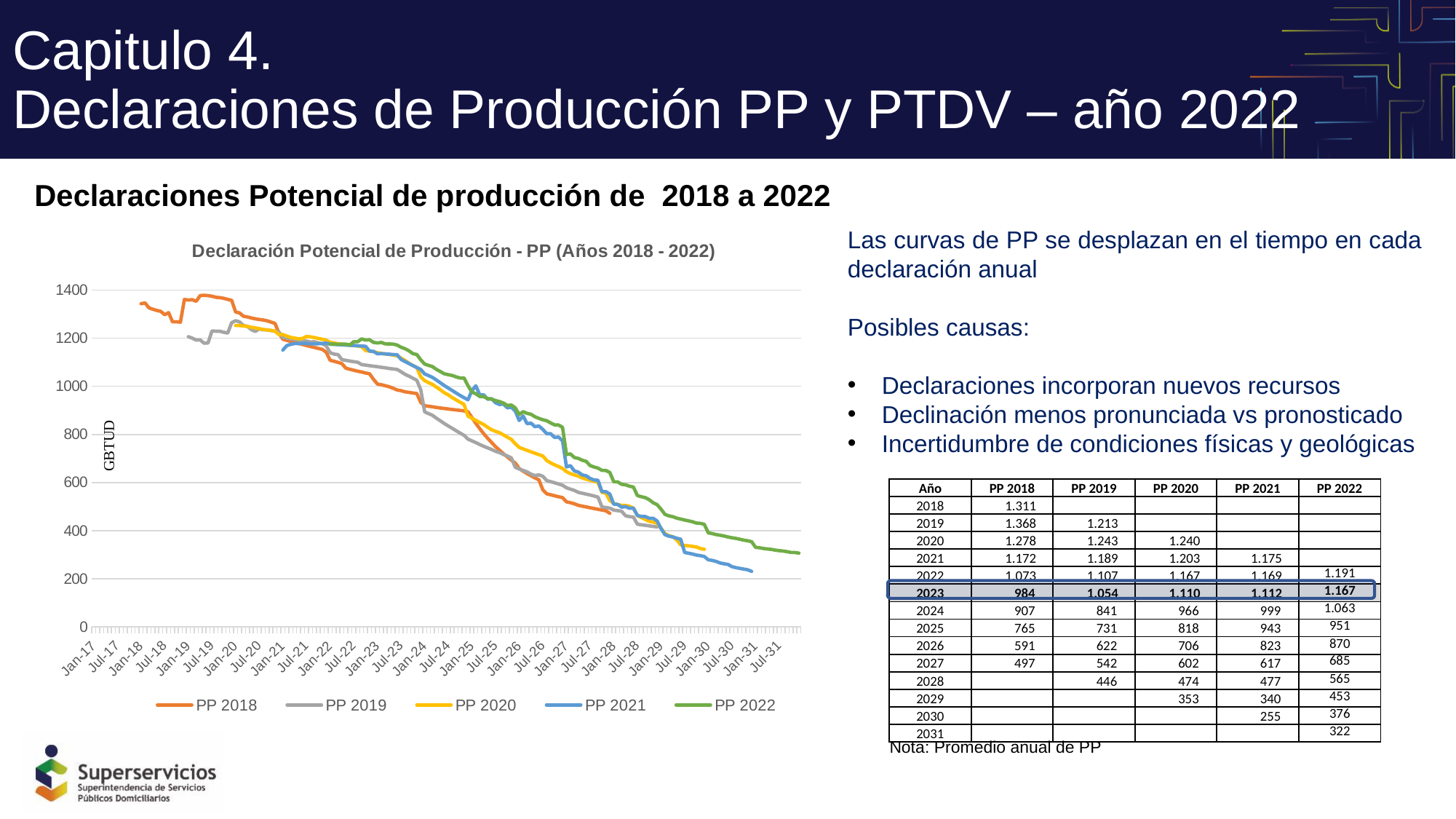
Is the value of PP 2019 at Jan-24 greater or less than 1000? less Which series extends furthest to the right along the x axis? PP 2022 What is the label on the vertical axis of the chart? GBTUD Which series starts earliest on the x axis? PP 2018 What kind of chart is shown on the slide? line chart What are the series names listed in the chart legend? PP 2018, PP 2019, PP 2020, PP 2021, PP 2022 Is the value of PP 2022 at Jul-31 greater or less than 400? less At Jan-27, which series has the higher value, PP 2022 or PP 2018? PP 2022 Is the value of PP 2018 at Jan-18 greater or less than 1200? greater Do the PP curves generally rise or fall as time moves along the x axis? fall How many series does the chart legend list? 5